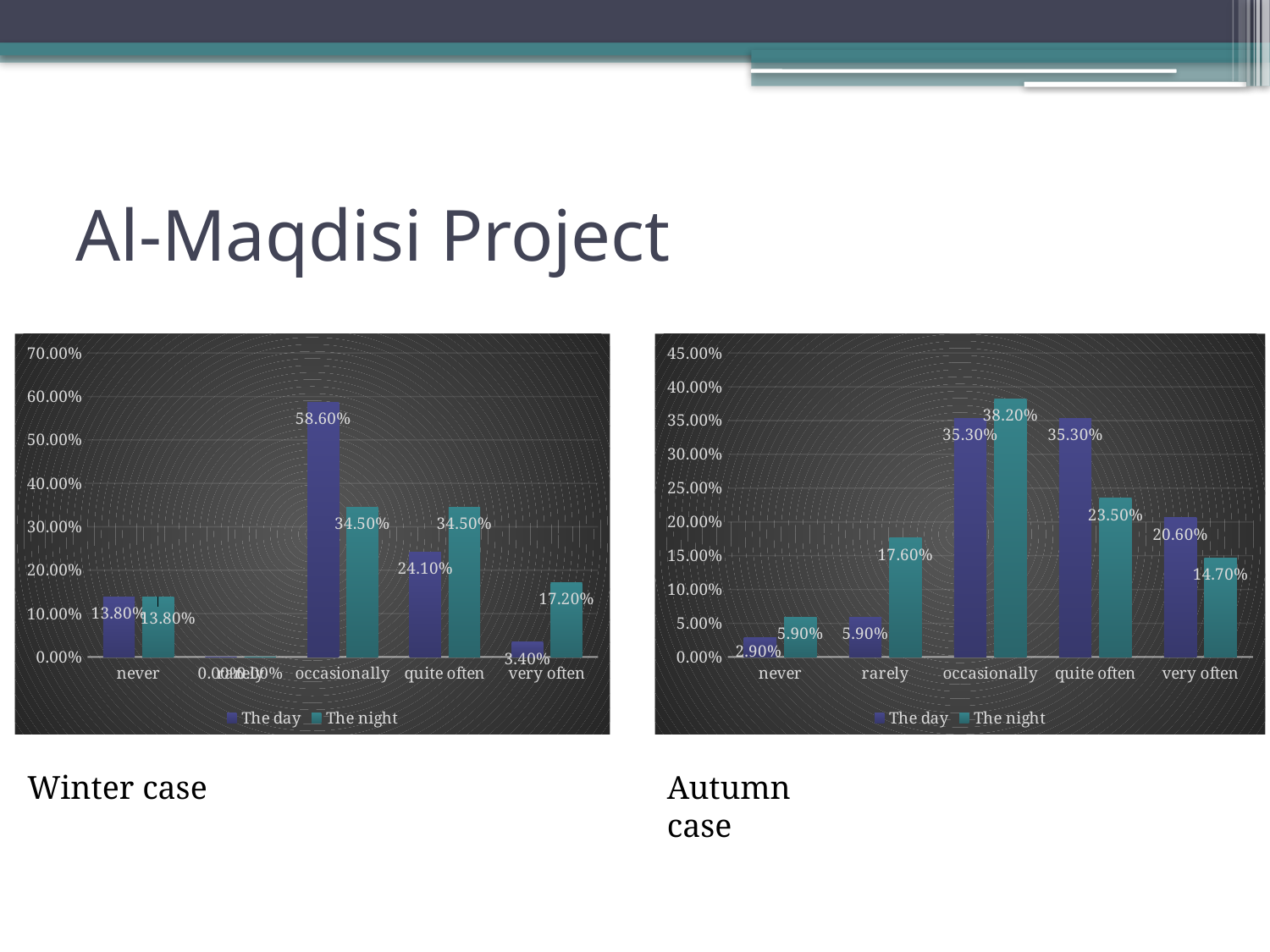
What kind of chart is the Winter case chart? bar chart In the Winter case chart, which is larger for quite often, The day or The night? The night In the Winter case chart, what is the difference between The day and The night for occasionally? 24.10% In the Autumn case chart, which category has the lowest value for The day? never In the Winter case chart, what is the value of The night for very often? 17.20% How many series does the legend of the Autumn case chart list? 2 In the Winter case chart, which category has the highest value for The day? occasionally In the Autumn case chart, what is the value of The day for very often? 20.60% In the Autumn case chart, what is the difference between The day and The night for quite often? 11.80% In the Autumn case chart, which is larger for occasionally, The day or The night? The night In the Winter case chart, what is the value of The day for occasionally? 58.60% In the Autumn case chart, what is the value of The night for rarely? 17.60%